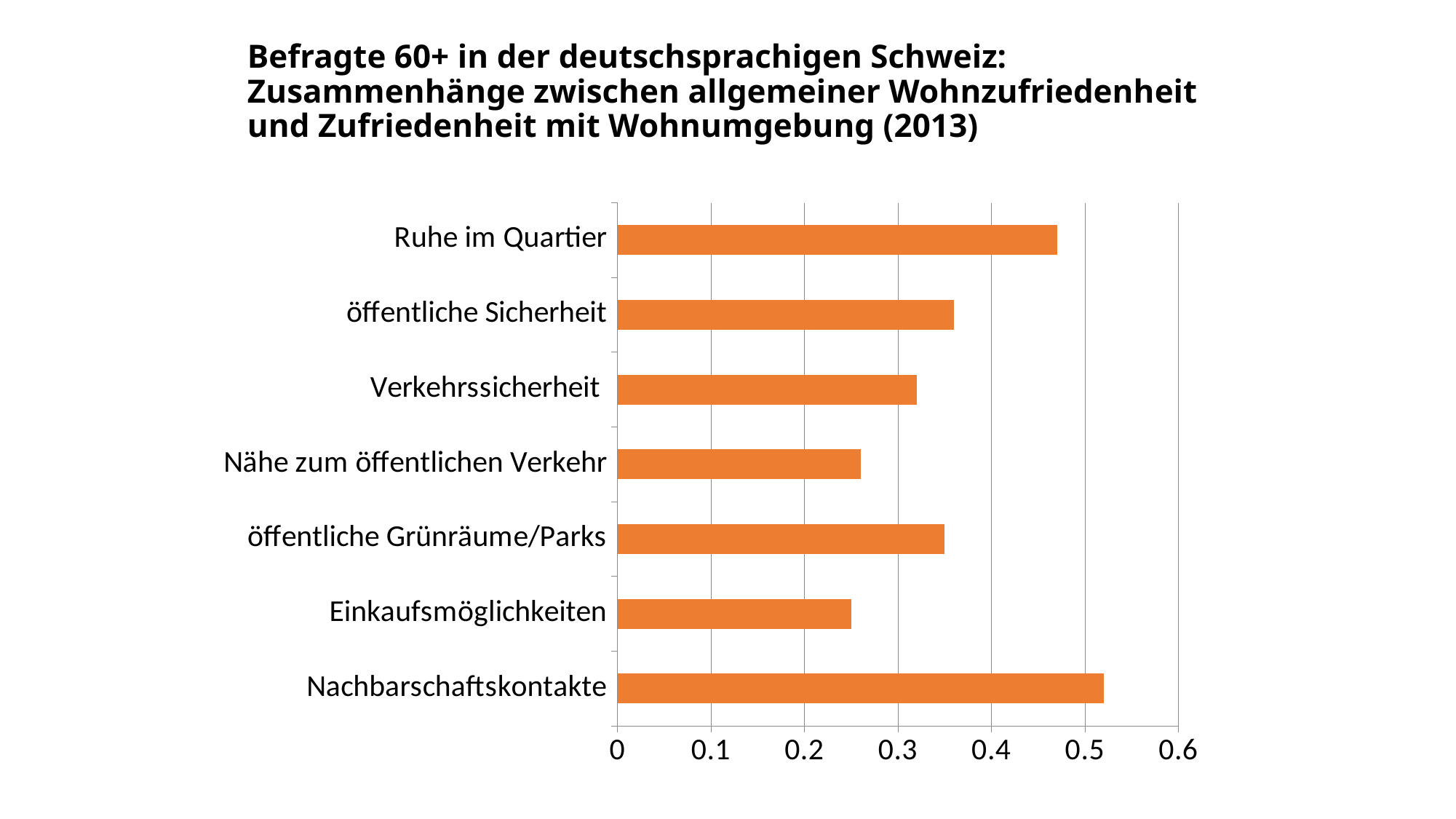
Is the value for Nähe zum öffentlichen Verkehr greater or less than 0.3? less Which category has the highest value in the chart? Nachbarschaftskontakte Is the value for öffentliche Sicherheit greater or less than 0.4? less Is the value for Ruhe im Quartier greater or less than 0.4? greater Which is larger, the value for Verkehrssicherheit or the value for Nähe zum öffentlichen Verkehr? Verkehrssicherheit Which is larger, the value for Ruhe im Quartier or the value for öffentliche Sicherheit? Ruhe im Quartier How many categories are plotted in the chart? 7 Which year is named in the chart title? 2013 What kind of chart is shown on the slide? bar chart